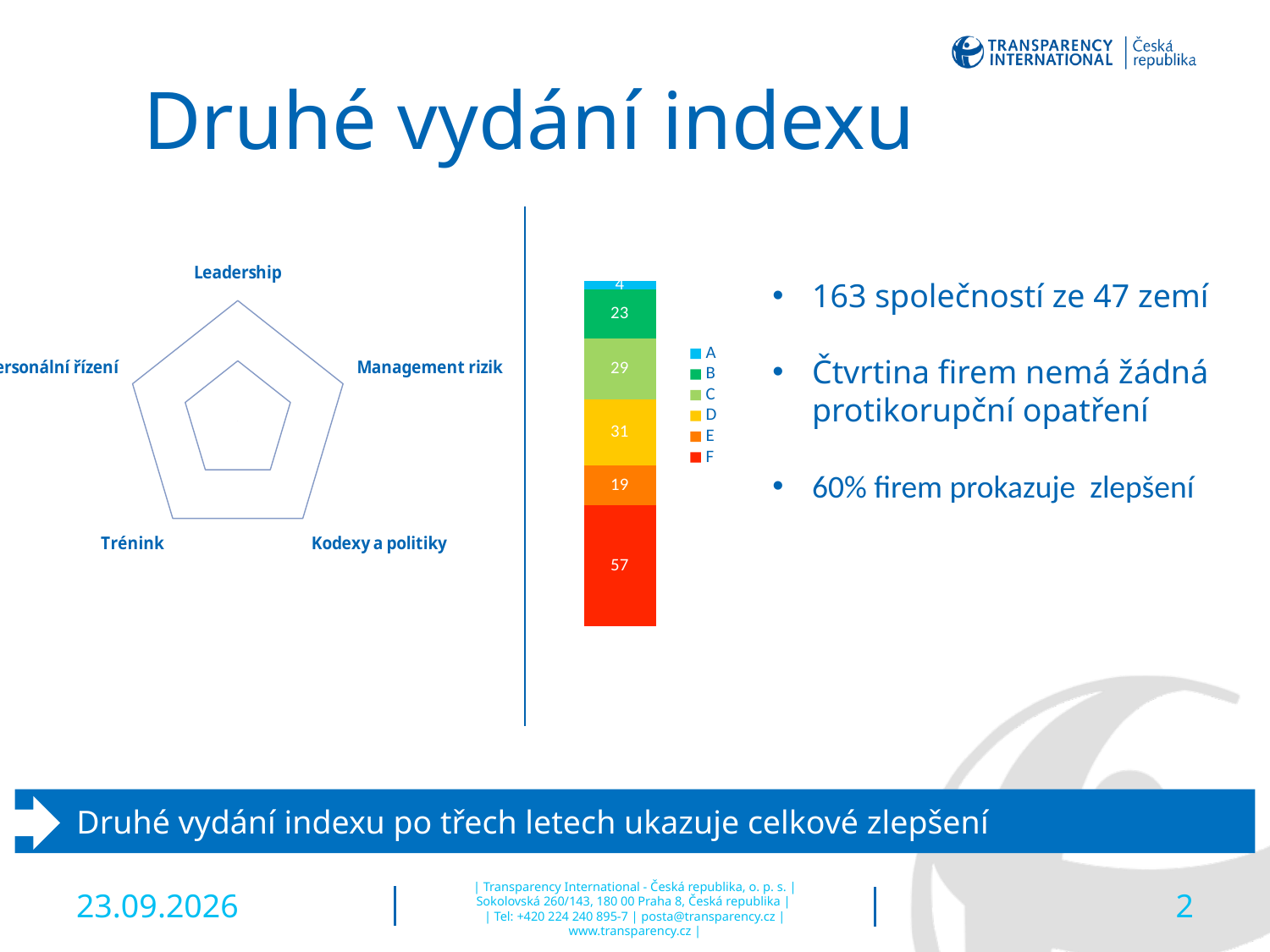
How many series does the legend of the stacked bar chart on the right list? 6 In the stacked bar chart on the right, what is the value of segment B? 23 In the stacked bar chart on the right, what is the difference between the values of segments F and D? 26 What kind of chart is the chart on the left of the slide? Radar chart How many axes (categories) does the radar chart on the left have? 5 In the stacked bar chart on the right, which segment has the smallest value? A What is the total of all segments in the stacked bar chart on the right? 163 In the stacked bar chart on the right, which segment has the larger value, C or E? C In the stacked bar chart on the right, which segment has the largest value? F In the stacked bar chart on the right, what is the value of segment D? 31 In the stacked bar chart on the right, what colour is segment F? Red In the stacked bar chart on the right, what is the value of segment F? 57